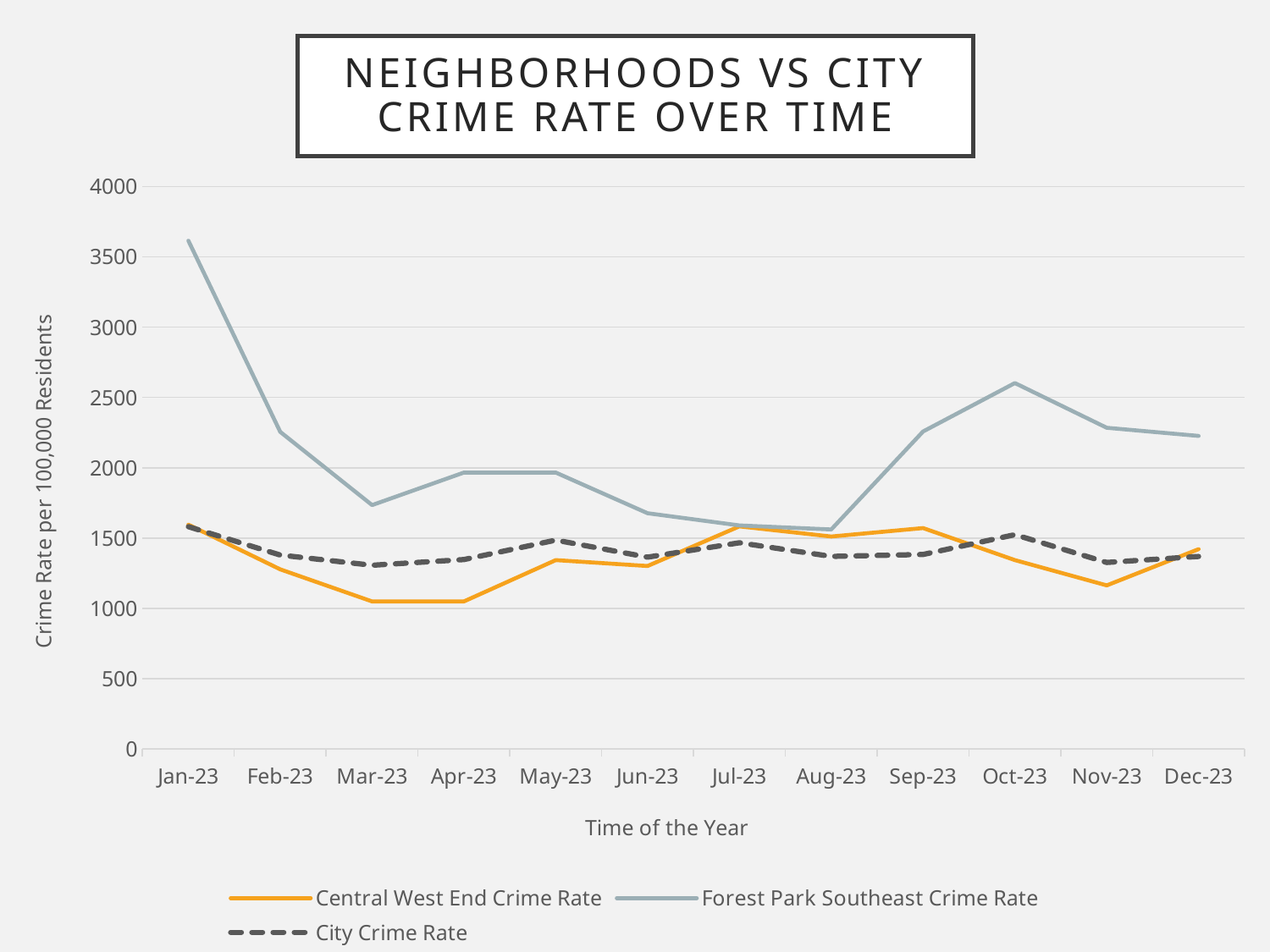
Is the Forest Park Southeast Crime Rate in Oct-23 greater or less than 2500? greater What is the label of the vertical axis? Crime Rate per 100,000 Residents Does the Forest Park Southeast Crime Rate rise or fall from Jan-23 to Mar-23? Fall In which month is the Forest Park Southeast Crime Rate highest? Jan-23 Is the Forest Park Southeast Crime Rate in Mar-23 greater or less than 2000? less How many series does the legend list? 3 Which is larger in Jan-23, the Forest Park Southeast Crime Rate or the Central West End Crime Rate? Forest Park Southeast Crime Rate What is the title of the chart? Neighborhoods vs City Crime Rate Over Time Is the Forest Park Southeast Crime Rate in Jan-23 greater or less than 3500? greater How many months are plotted along the x axis? 12 What kind of chart is shown on the slide? Line chart